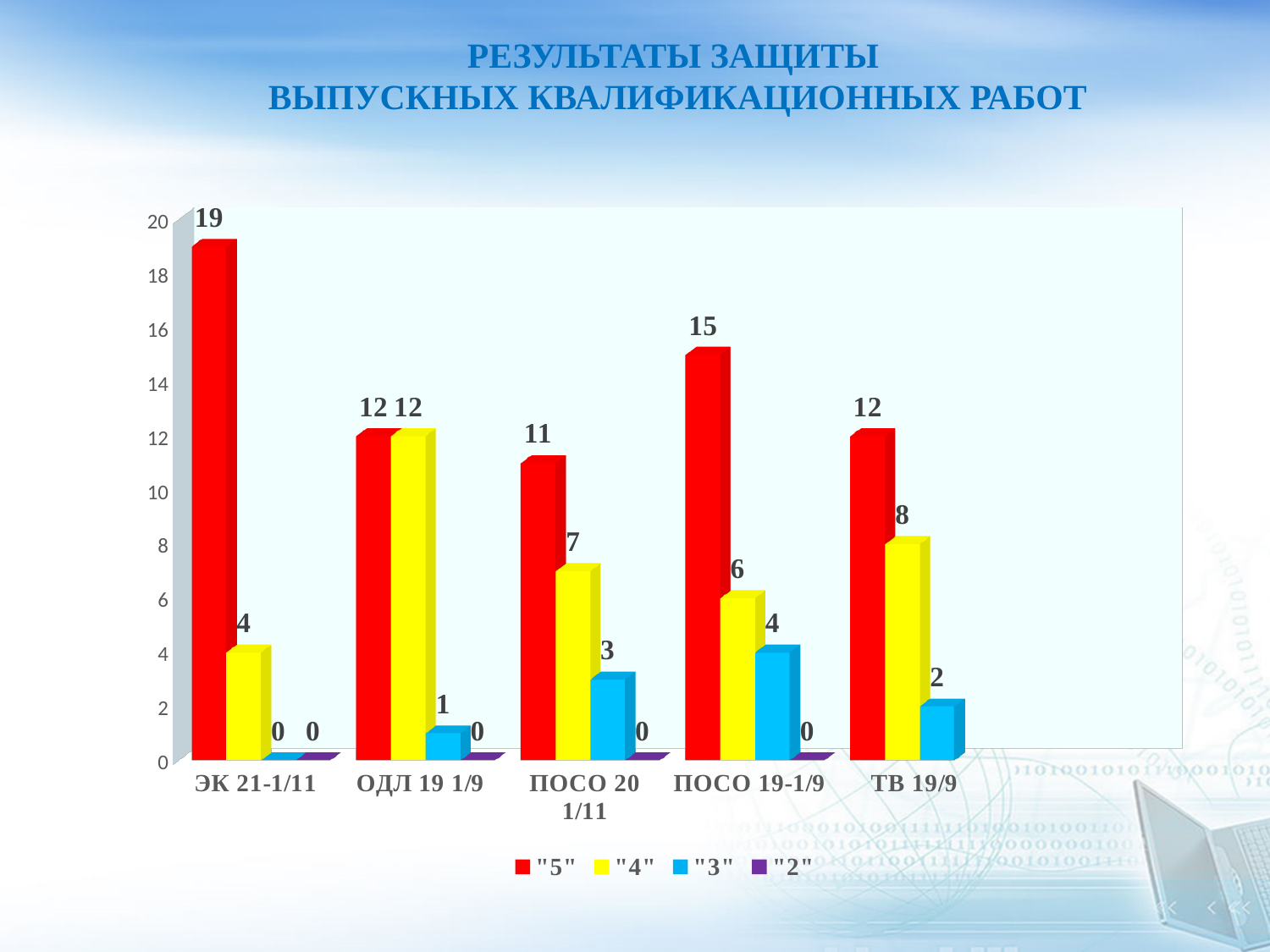
What is the value of the "3" series for ОДЛ 19 1/9? 1 Which is larger for ПОСО 19-1/9: the "5" value or the "4" value? "5" What is the difference between the "5" and "4" values for ПОСО 20 1/11? 4 What kind of chart is shown on the slide? Bar chart How many series does the legend list? 4 What is the value of the "3" series for ПОСО 19-1/9? 4 What colour represents the "3" series in the legend? Blue What is the value of the "5" series for ЭК 21-1/11? 19 Which category has the lowest value in the "4" series? ЭК 21-1/11 How many categories are shown on the x axis? 5 Which category has the highest value in the "5" series? ЭК 21-1/11 What is the value of the "4" series for ТВ 19/9? 8